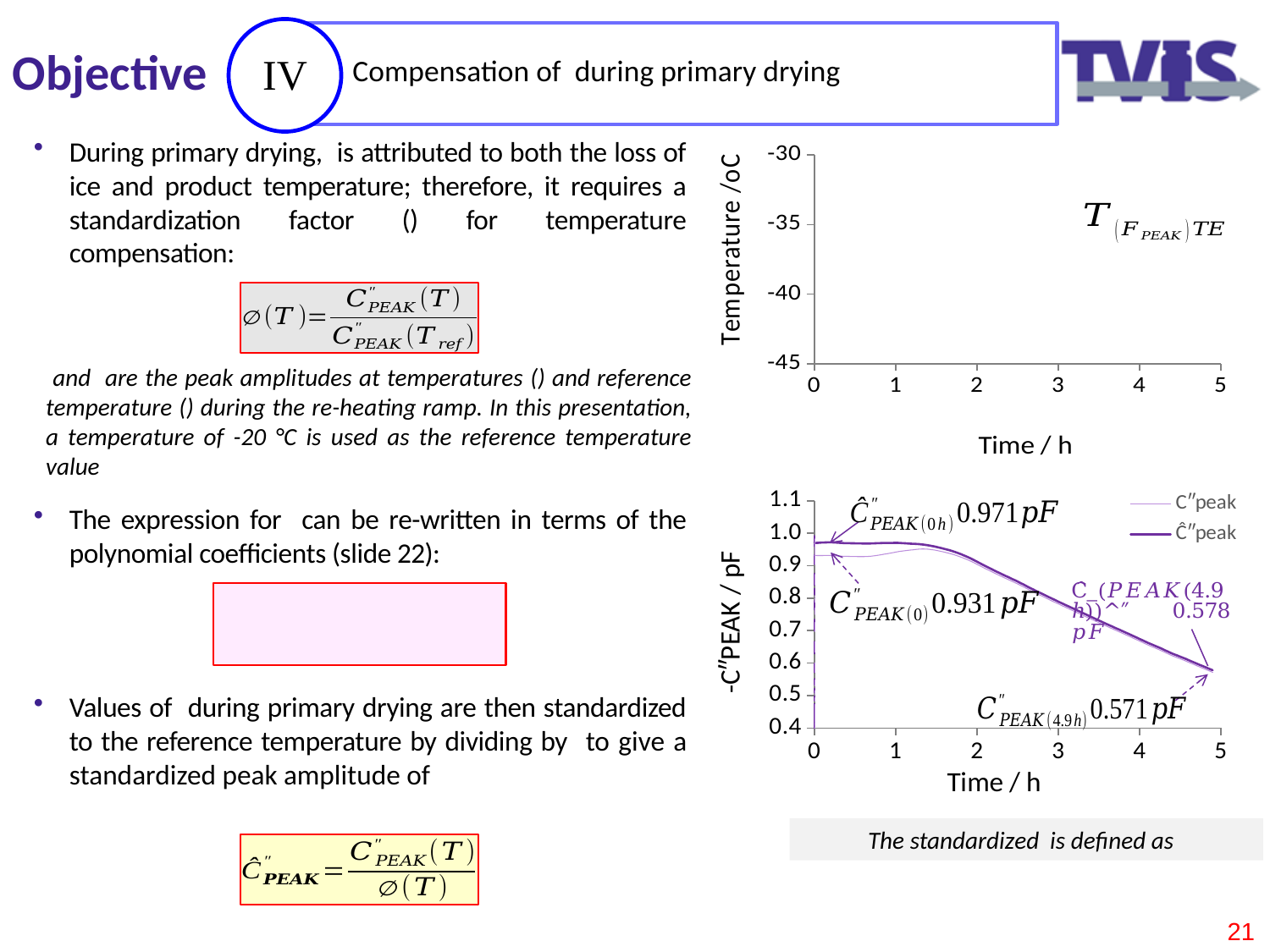
In the lower chart, which is larger at 0 h: the annotated Ĉ''PEAK value or the annotated C''PEAK value? Ĉ''PEAK What is the y-axis label of the upper chart on the slide? Temperature /oC In the lower chart, what is the annotated value of Ĉ''PEAK at 4.9 h? 0.578 pF What kind of chart is the lower chart on the slide (the one with -C''PEAK / pF on the y axis)? line chart In the lower chart, what is the annotated value of C''PEAK at 0 h? 0.931 pF In the lower chart, what is the annotated value of Ĉ''PEAK at 0 h? 0.971 pF In the lower chart, is the value of Ĉ''peak at 3 h greater or less than 0.9? less In the lower chart, what is the difference between the annotated Ĉ''PEAK values at 0 h and at 4.9 h? 0.393 pF In the lower chart, what is the difference between the annotated C''PEAK values at 0 h and at 4.9 h? 0.360 pF In the lower chart, how many series does the legend list? 2 In the lower chart, what is the annotated value of C''PEAK at 4.9 h? 0.571 pF In the lower chart, do the plotted values rise or fall as time increases from about 2 h to 5 h? fall